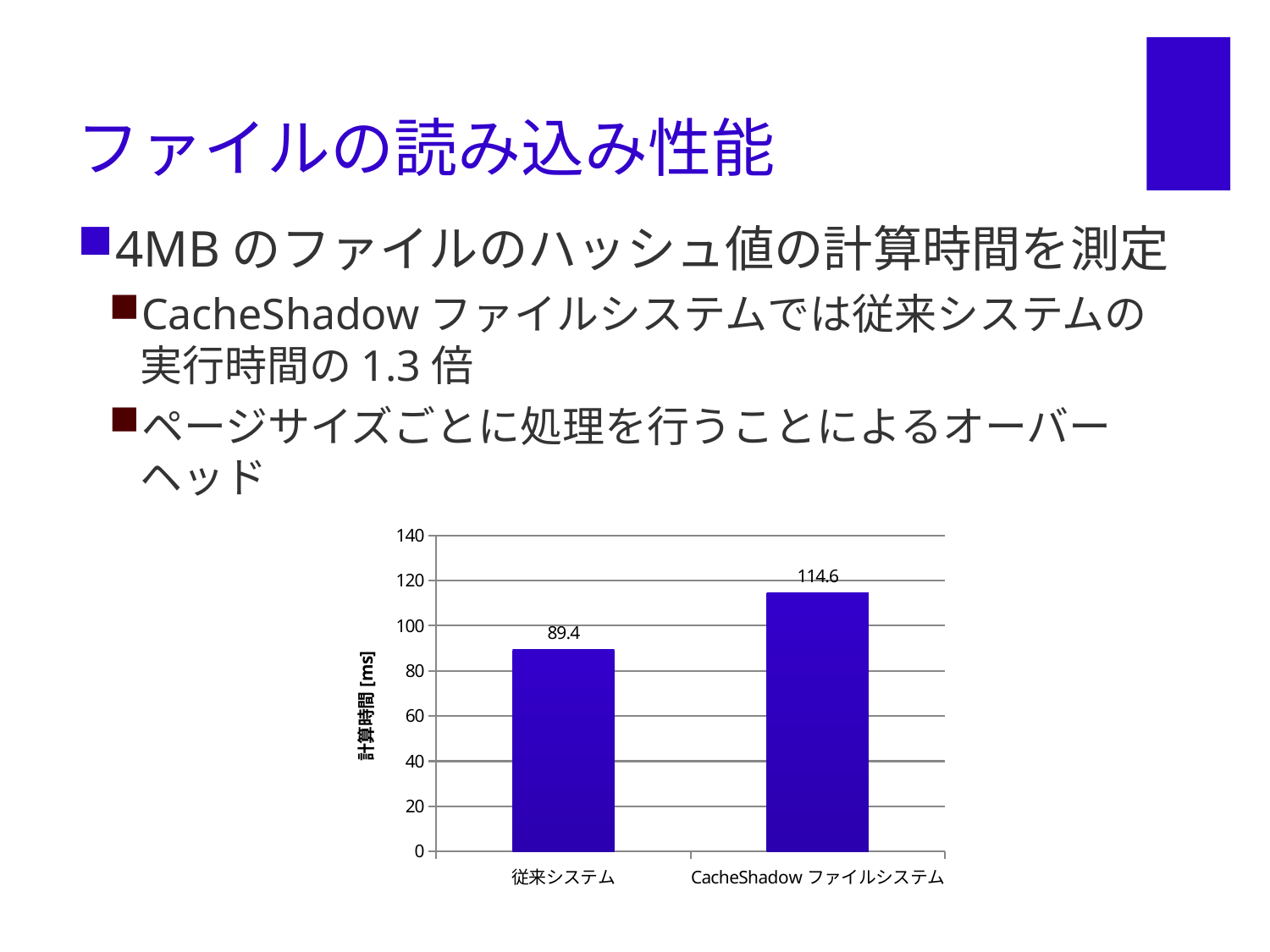
Is the value for 従来システム greater or less than 100? less Which category has the lowest value? 従来システム How many categories are shown in the chart? 2 Which category has the highest value? CacheShadow ファイルシステム What is the value for CacheShadow ファイルシステム? 114.6 What is the maximum value shown on the vertical axis? 140 What is the label of the vertical axis? 計算時間 [ms] What is the value for 従来システム? 89.4 Is the value for CacheShadow ファイルシステム greater or less than 100? greater Which is larger, the value for 従来システム or the value for CacheShadow ファイルシステム? CacheShadow ファイルシステム What is the difference between the values for CacheShadow ファイルシステム and 従来システム? 25.2 What kind of chart is shown on the slide? bar chart